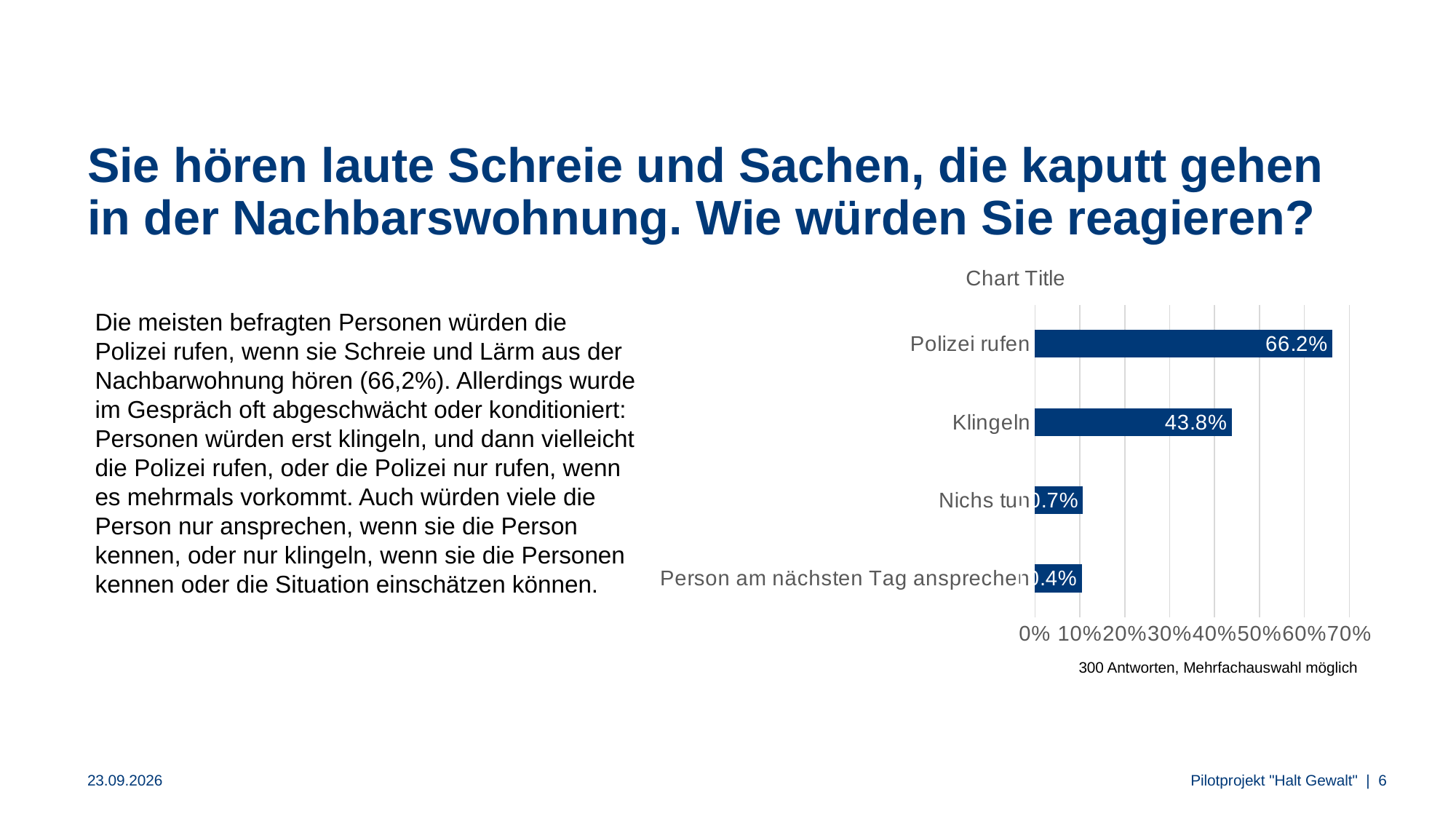
What is the value for "Polizei rufen"? 66.2% Is the value for "Klingeln" greater or less than 40%? greater Which category has the highest value? Polizei rufen What kind of chart is shown on the slide? bar chart What is the title shown above the chart? Chart Title Is the value for "Nichs tun" greater or less than 20%? less What note is printed below the chart's axis? 300 Antworten, Mehrfachauswahl möglich How many categories are shown in the chart? 4 Which is larger, the value for "Polizei rufen" or the value for "Klingeln"? Polizei rufen Is the value for "Person am nächsten Tag ansprechen" greater or less than 20%? less What is the difference between the values for "Polizei rufen" and "Klingeln"? 22.4% What is the value for "Klingeln"? 43.8%